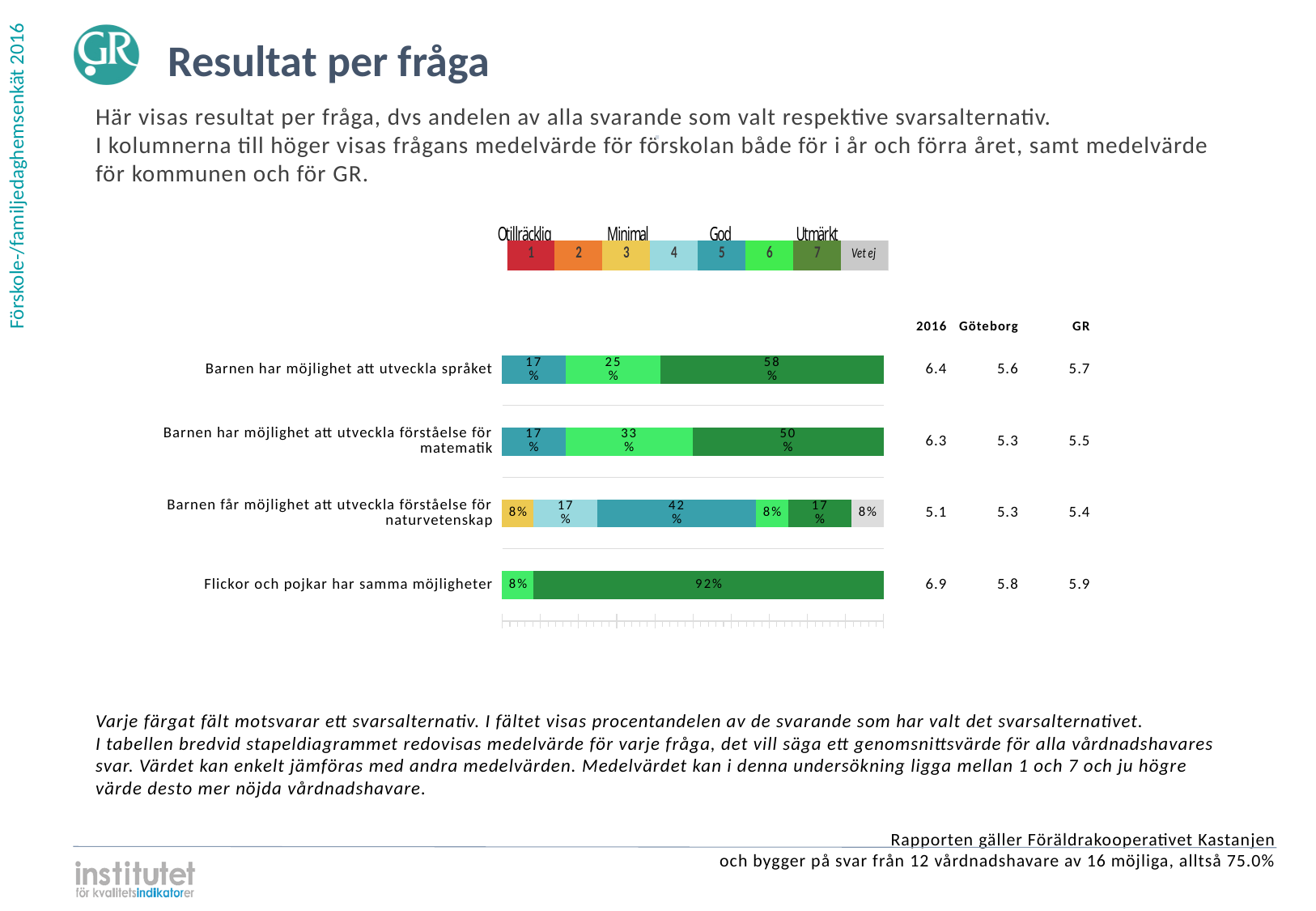
How many percentage points higher is the share of answer 7 for "Barnen har möjlighet att utveckla språket" than for "Barnen har möjlighet att utveckla förståelse för matematik"? 8 percentage points What percentage of respondents chose answer 5 for "Barnen får möjlighet att utveckla förståelse för naturvetenskap"? 42% Which question has the highest share of respondents choosing answer 7? Flickor och pojkar har samma möjligheter How many questions (bars) are shown in the chart? 4 Which question has the lowest 2016 mean value? Barnen får möjlighet att utveckla förståelse för naturvetenskap What label does the legend give to answer option 7? Utmärkt What percentage of respondents chose answer 7 for "Flickor och pojkar har samma möjligheter"? 92% What kind of chart is shown on the slide? Stacked bar chart What is the Göteborg mean value for "Barnen har möjlighet att utveckla förståelse för matematik"? 5.3 What percentage of respondents chose answer 7 for "Barnen har möjlighet att utveckla språket"? 58% What is the 2016 mean value for "Flickor och pojkar har samma möjligheter"? 6.9 Which question has a larger share of answer 6: "Barnen har möjlighet att utveckla språket" or "Barnen har möjlighet att utveckla förståelse för matematik"? Barnen har möjlighet att utveckla förståelse för matematik